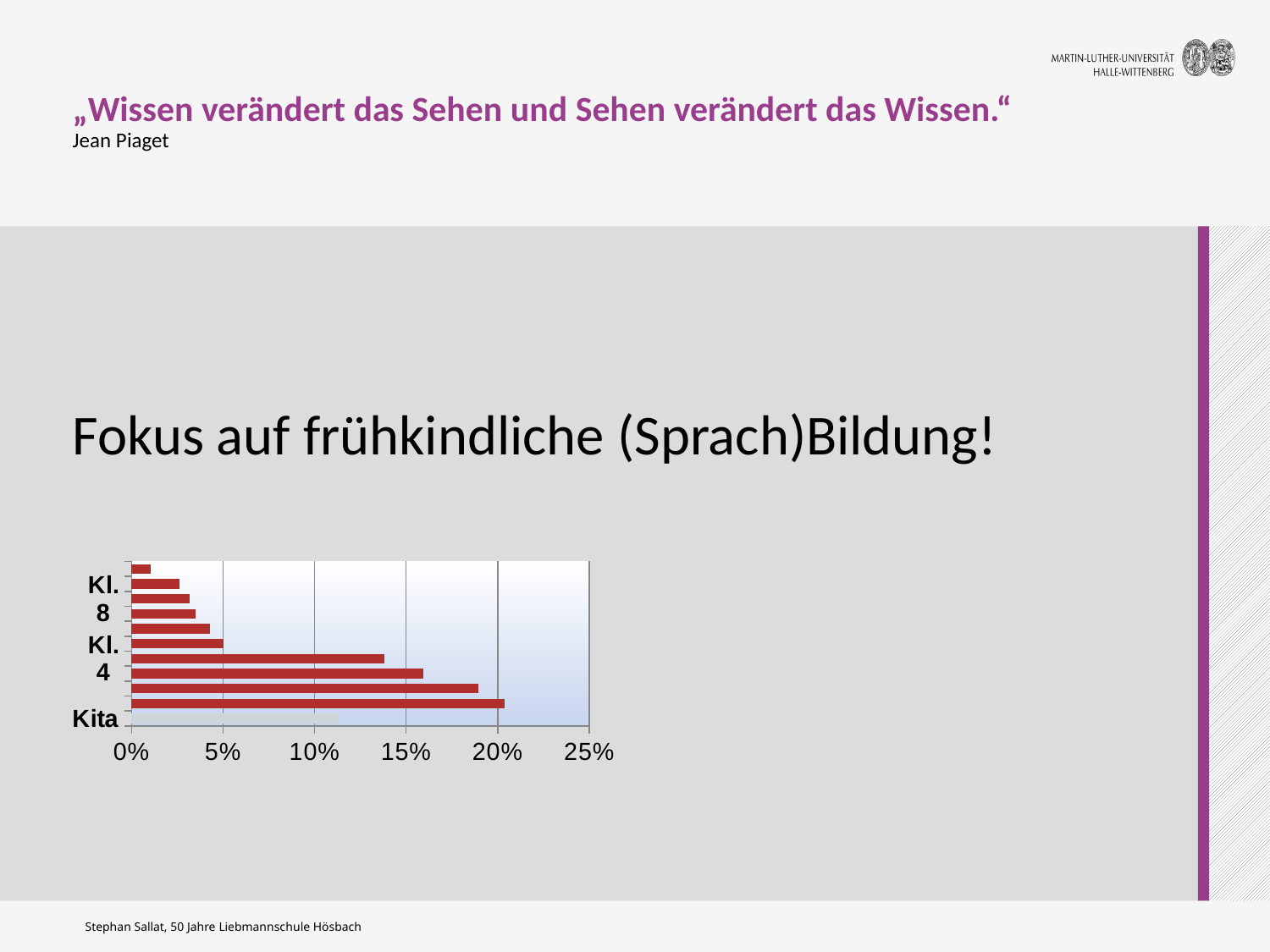
Is the value of the bar for Kita greater or less than 15%? less Which is larger: the bar for Kita or the topmost bar of the chart? Kita What kind of chart is shown on the slide? bar chart Are the bars next to the Kl. 4 label greater or less than 10%? greater What is the highest value shown on the horizontal axis of the chart? 25% Do the bars generally get longer or shorter moving from the top of the chart (Kl. 8) down toward Kita? longer How many bars are plotted in the chart? 11 Is the shortest bar in the chart greater or less than 5%? less Which category labels are readable on the vertical axis of the chart? Kita, Kl. 4, Kl. 8